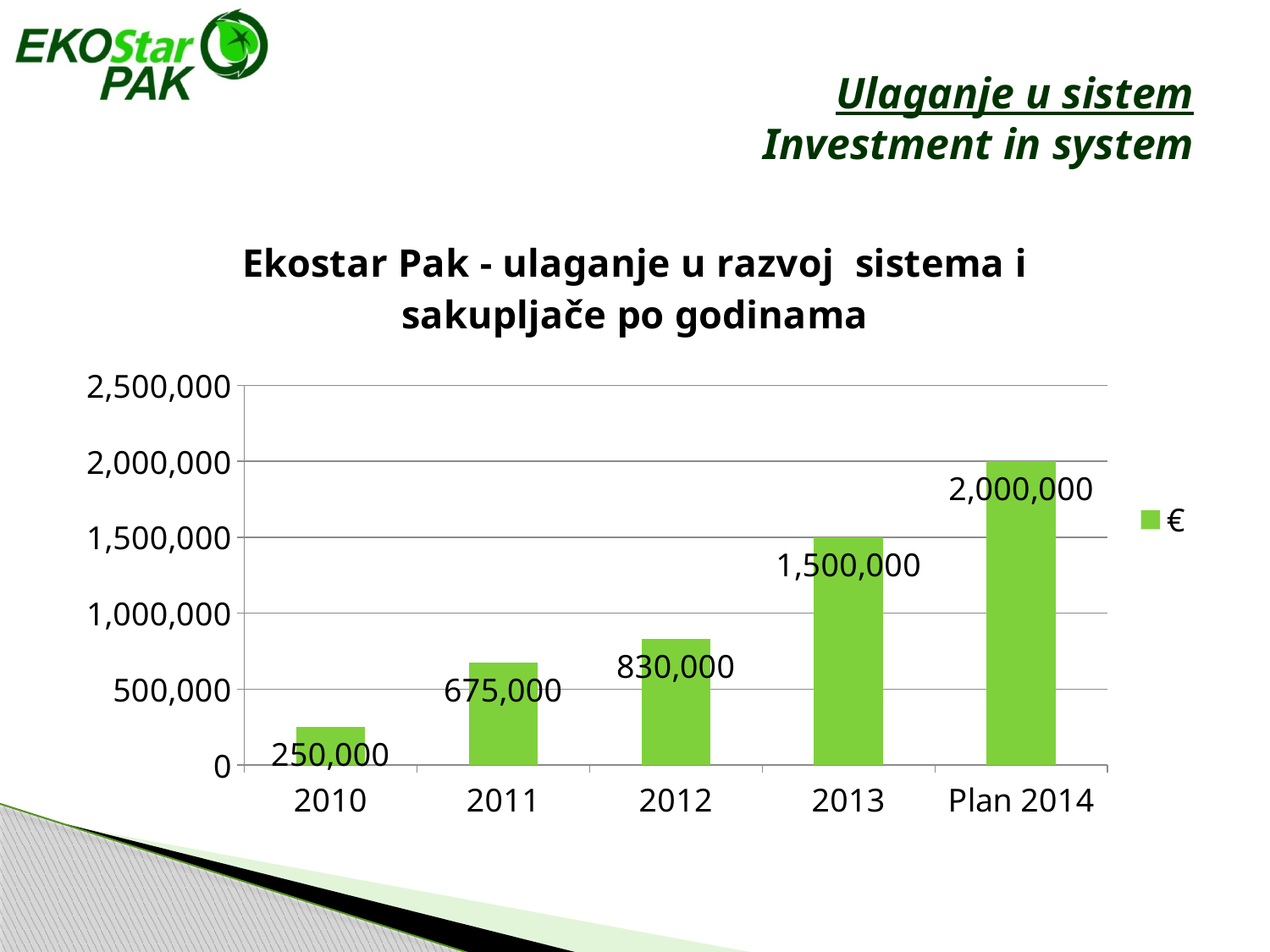
Which category has the highest value? Plan 2014 Do the values rise or fall from 2010 to Plan 2014? rise How many series does the legend list? 1 What kind of chart is shown? bar chart How many categories are shown on the x axis? 5 What is the difference between the values for 2013 and 2012? 670,000 What is the difference between the values for 2011 and 2010? 425,000 What is the value for 2010? 250,000 What is the value for 2012? 830,000 Which category has the lowest value? 2010 Which is larger, the value for 2011 or the value for 2012? 2012 What is the value for Plan 2014? 2,000,000